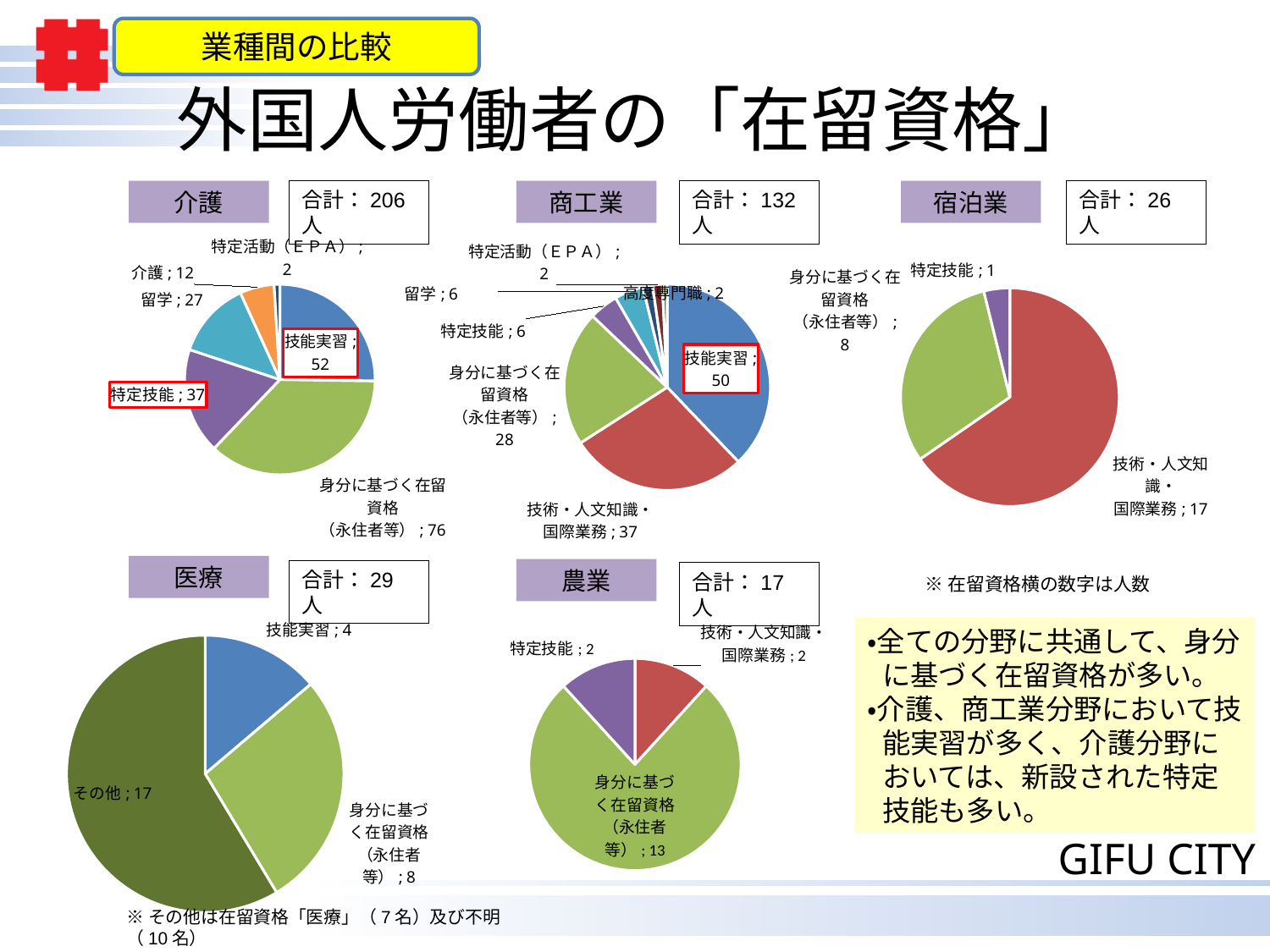
What type of chart is used for the 介護 data? Pie chart In the 介護 pie chart, which category has the largest value? 身分に基づく在留資格（永住者等） How many categories are shown in the 宿泊業 pie chart? 3 In the 宿泊業 pie chart, which category has the smallest value? 特定技能 In the 医療 pie chart, what is the value for その他? 17 What is the total shown for the 医療 chart? 29人 In the 介護 pie chart, what is the difference between 身分に基づく在留資格（永住者等） and 特定技能? 39 In the 農業 pie chart, what share of the total does 身分に基づく在留資格（永住者等） represent? 13 of 17 In the 介護 pie chart, what is the value for 技能実習? 52 In the 商工業 pie chart, which is larger, 技能実習 or 身分に基づく在留資格（永住者等）? 技能実習 How many categories are shown in the 農業 pie chart? 3 In the 商工業 pie chart, what is the value for 技術・人文知識・国際業務? 37